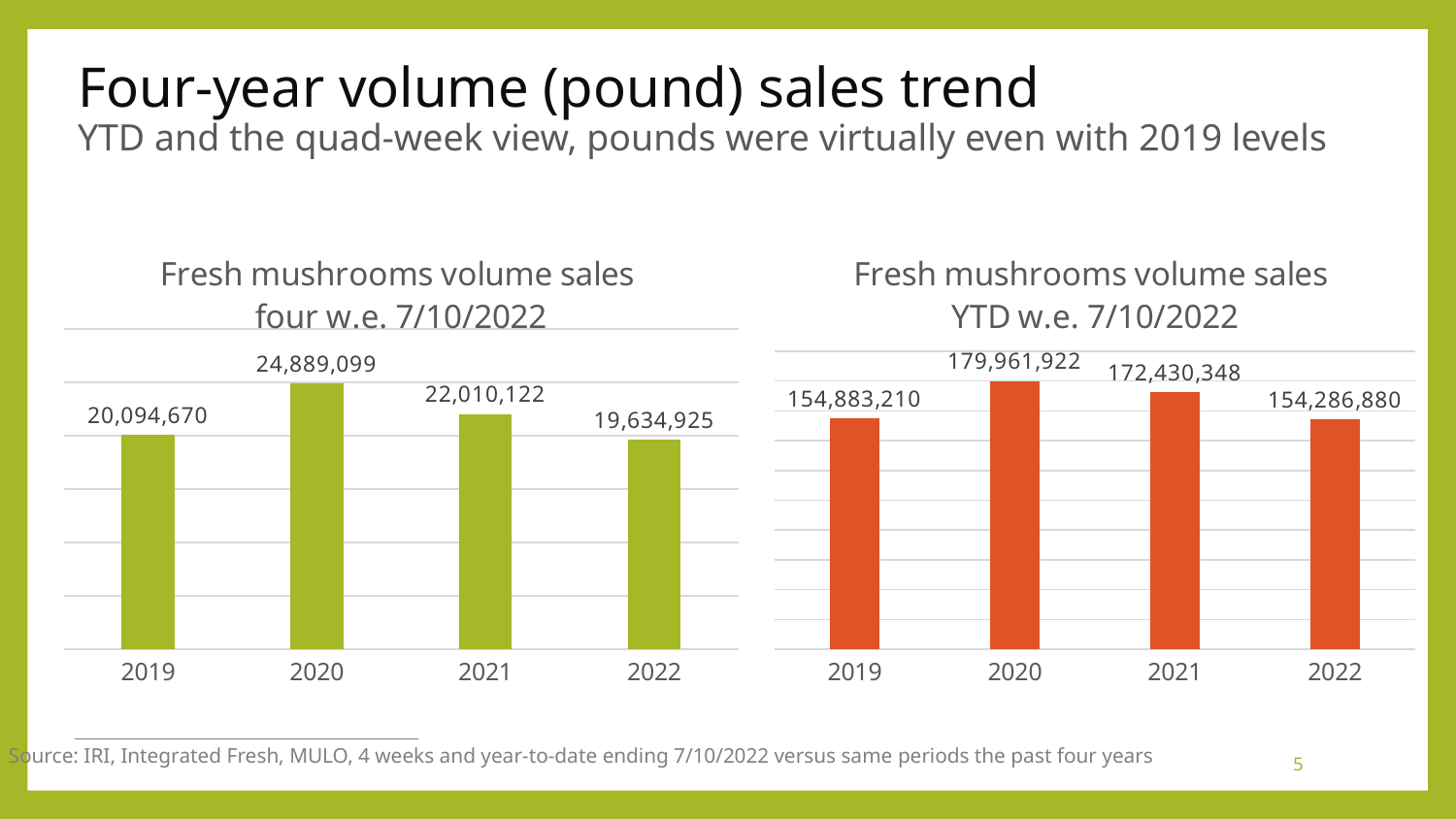
In the 'Fresh mushrooms volume sales four w.e. 7/10/2022' chart, what is the value for 2020? 24,889,099 In the 'Fresh mushrooms volume sales YTD w.e. 7/10/2022' chart, which year has the highest value? 2020 How many years are shown in the 'Fresh mushrooms volume sales four w.e. 7/10/2022' chart? 4 In the 'Fresh mushrooms volume sales YTD w.e. 7/10/2022' chart, what is the difference between the 2020 and 2022 values? 25,675,042 In the 'Fresh mushrooms volume sales four w.e. 7/10/2022' chart, which year has the lowest value? 2022 What kind of chart is the 'Fresh mushrooms volume sales YTD w.e. 7/10/2022' chart? Bar chart In the 'Fresh mushrooms volume sales YTD w.e. 7/10/2022' chart, which is larger, the value for 2021 or the value for 2019? 2021 In the 'Fresh mushrooms volume sales four w.e. 7/10/2022' chart, what is the value for 2019? 20,094,670 In the 'Fresh mushrooms volume sales four w.e. 7/10/2022' chart, do the values rise or fall from 2020 to 2022? Fall In the 'Fresh mushrooms volume sales YTD w.e. 7/10/2022' chart, what is the value for 2022? 154,286,880 What colour are the bars in the 'Fresh mushrooms volume sales YTD w.e. 7/10/2022' chart? Orange In the 'Fresh mushrooms volume sales four w.e. 7/10/2022' chart, what is the difference between the 2020 and 2019 values? 4,794,429